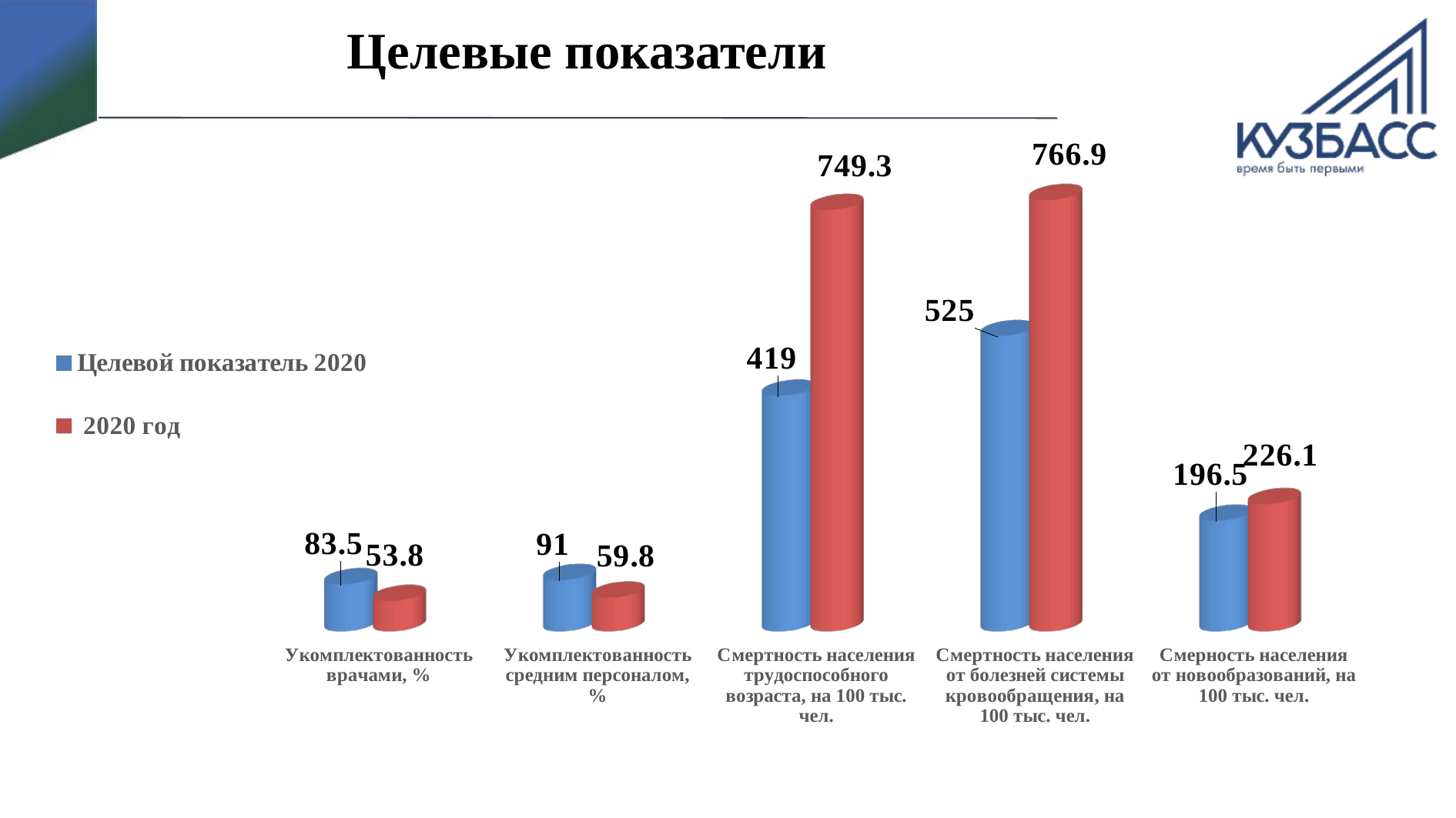
What is the value of "2020 год" for "Смерность населения от новообразований, на 100 тыс. чел."? 226.1 What is the value of "Целевой показатель 2020" for "Укомплектованность врачами, %"? 83.5 What is the difference between "2020 год" and "Целевой показатель 2020" for "Смертность населения от болезней системы кровообращения, на 100 тыс. чел."? 241.9 For "Укомплектованность врачами, %", which is larger: "Целевой показатель 2020" or "2020 год"? Целевой показатель 2020 Which category has the highest value for the "2020 год" series? Смертность населения от болезней системы кровообращения, на 100 тыс. чел. For "Смерность населения от новообразований, на 100 тыс. чел.", which is larger: "Целевой показатель 2020" or "2020 год"? 2020 год What is the difference between "Целевой показатель 2020" and "2020 год" for "Укомплектованность средним персоналом, %"? 31.2 What is the value of "2020 год" for "Смертность населения трудоспособного возраста, на 100 тыс. чел."? 749.3 How many categories are shown on the chart? 5 Which category has the lowest value for the "Целевой показатель 2020" series? Укомплектованность врачами, % What kind of chart is shown on the slide? Bar chart How many series does the legend list? 2